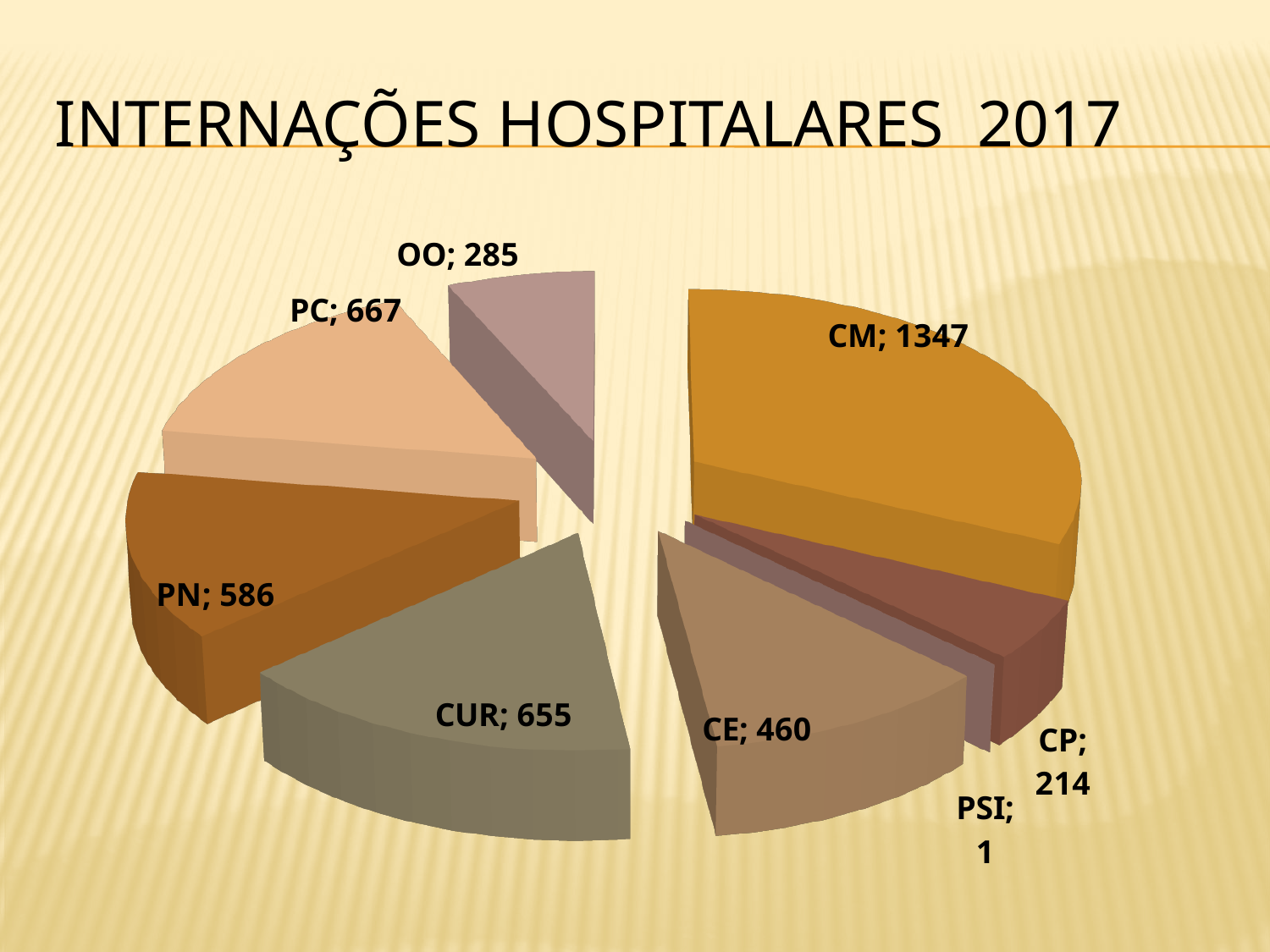
What is the title of the slide containing the chart? INTERNAÇÕES HOSPITALARES 2017 What is the total of all the values shown in the pie chart? 4215 Which is larger, the value for PN or the value for CE? PN What is the value for CP in the pie chart? 214 What is the value for PN in the pie chart? 586 Which category has the largest slice in the pie chart? CM What is the value for CM in the pie chart? 1347 How many categories are shown in the pie chart? 8 What kind of chart is shown on the slide? Pie chart What is the difference between the values for PC and CUR? 12 Which category has the smallest value in the pie chart? PSI What is the difference between the values for CM and CE? 887